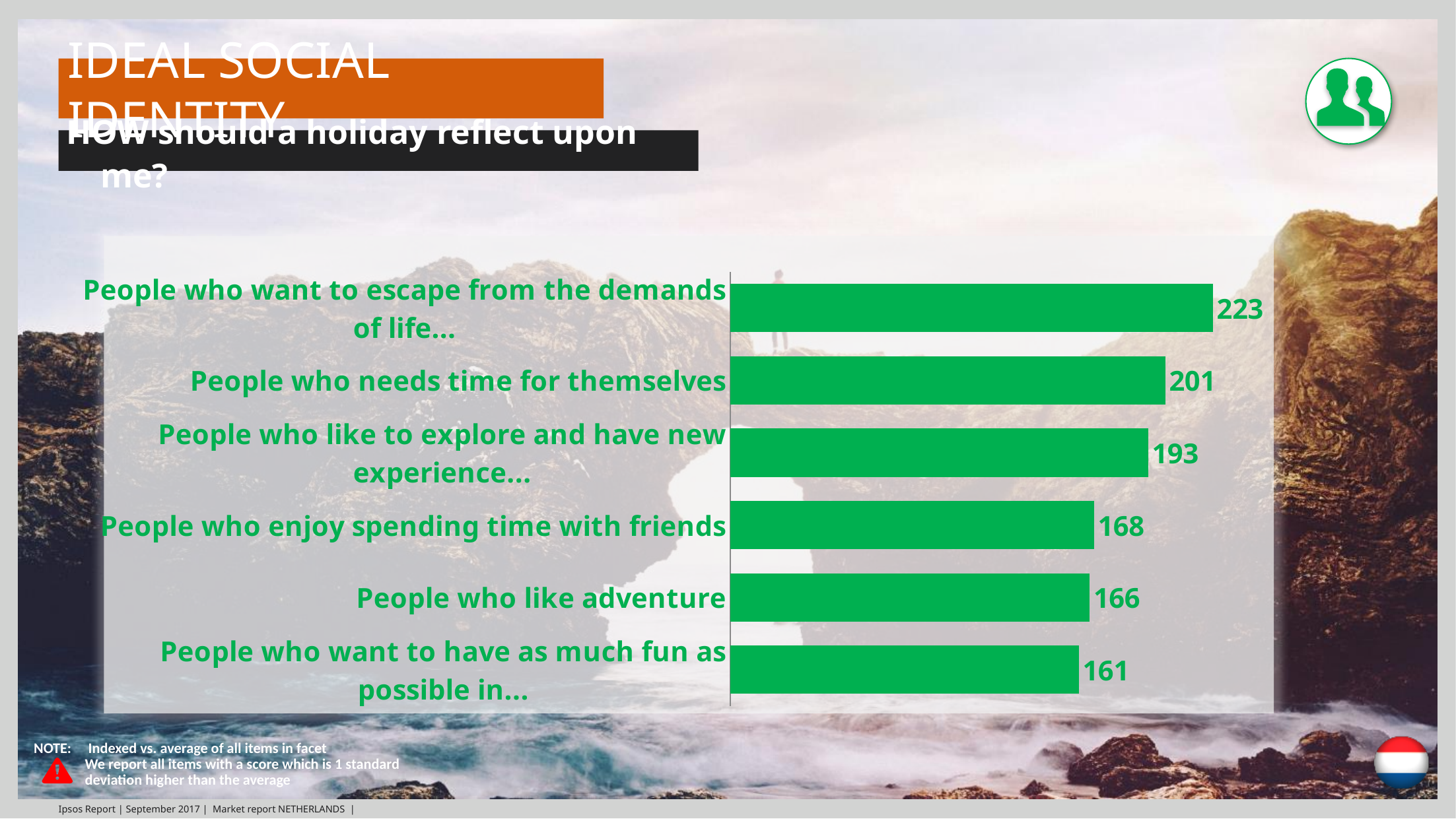
Which category has the lowest value? People who want to have as much fun as possible in... What is the value for "People who want to escape from the demands of life..."? 223 Which is larger: the value for "People who like to explore and have new experience..." or "People who enjoy spending time with friends"? People who like to explore and have new experience... How many categories are shown in the chart? 6 What is the value for "People who needs time for themselves"? 201 What is the value for "People who like adventure"? 166 What is the value for "People who want to have as much fun as possible in..."? 161 Which category has the highest value? People who want to escape from the demands of life... What kind of chart is shown on the slide? Bar chart What is the difference between the values for "People who want to escape from the demands of life..." and "People who needs time for themselves"? 22 What is the value for "People who enjoy spending time with friends"? 168 What is the value for "People who like to explore and have new experience..."? 193